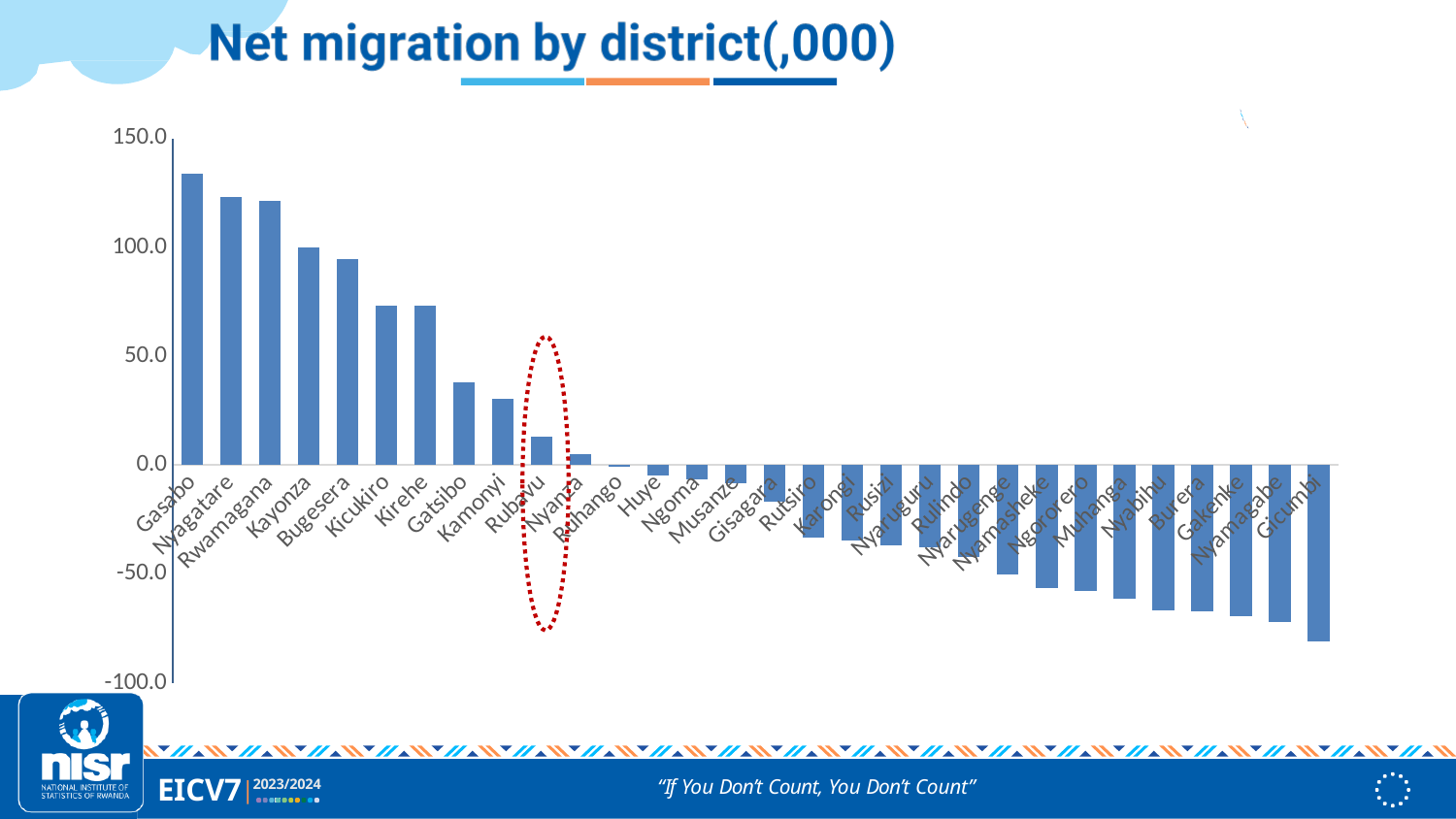
Which district's bar is highlighted with a red dotted circle? Rubavu Is the value for Kicukiro greater or less than 50.0? greater Do the values rise or fall moving from left to right along the x axis? fall What type of chart is shown on the slide? bar chart Is the value for Gatsibo greater or less than 50.0? less Which has the larger net migration, Gasabo or Nyagatare? Gasabo Is the value for Gicumbi greater or less than -50.0? less Which district has the lowest net migration? Gicumbi How many districts are shown on the x axis? 30 Which district has the highest net migration? Gasabo